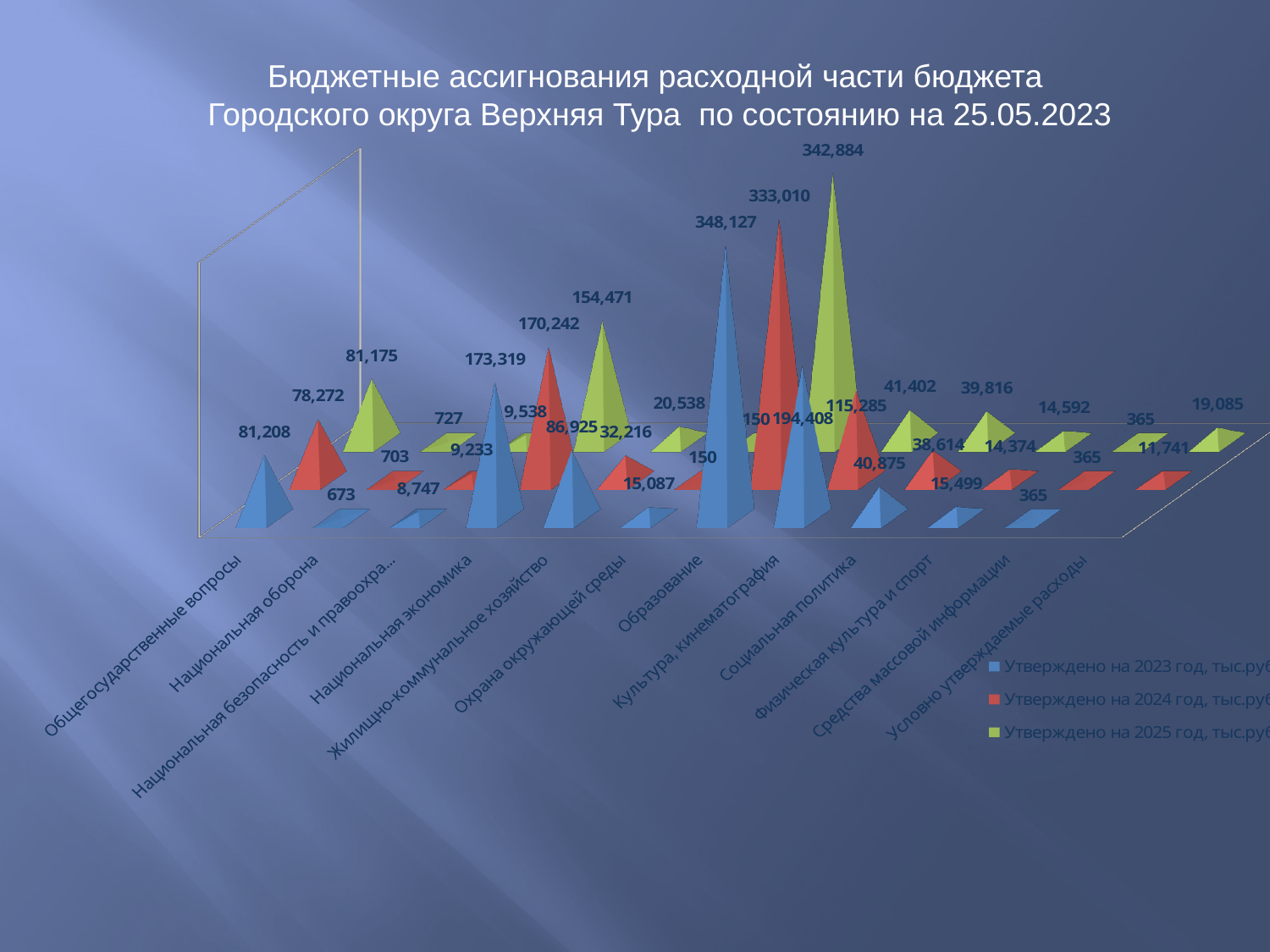
What kind of chart is shown on the slide? bar chart What colour represents the series 'Утверждено на 2025 год, тыс.руб' in the legend? green What is the value for Образование in the series 'Утверждено на 2025 год, тыс.руб'? 342,884 How many categories are shown along the x axis? 12 What is the value for Образование in the series 'Утверждено на 2023 год, тыс.руб'? 348,127 For Национальная экономика, which is larger: the value for 2023 or the value for 2025? 2023 How many series does the legend list? 3 Which category has the highest value in the series 'Утверждено на 2023 год, тыс.руб'? Образование What is the difference between the 2023 and 2024 values for Образование? 15,117 What is the value for Общегосударственные вопросы in the series 'Утверждено на 2024 год, тыс.руб'? 78,272 What is the value for Национальная оборона in the series 'Утверждено на 2023 год, тыс.руб'? 673 What is the value for Условно утверждаемые расходы in the series 'Утверждено на 2025 год, тыс.руб'? 19,085